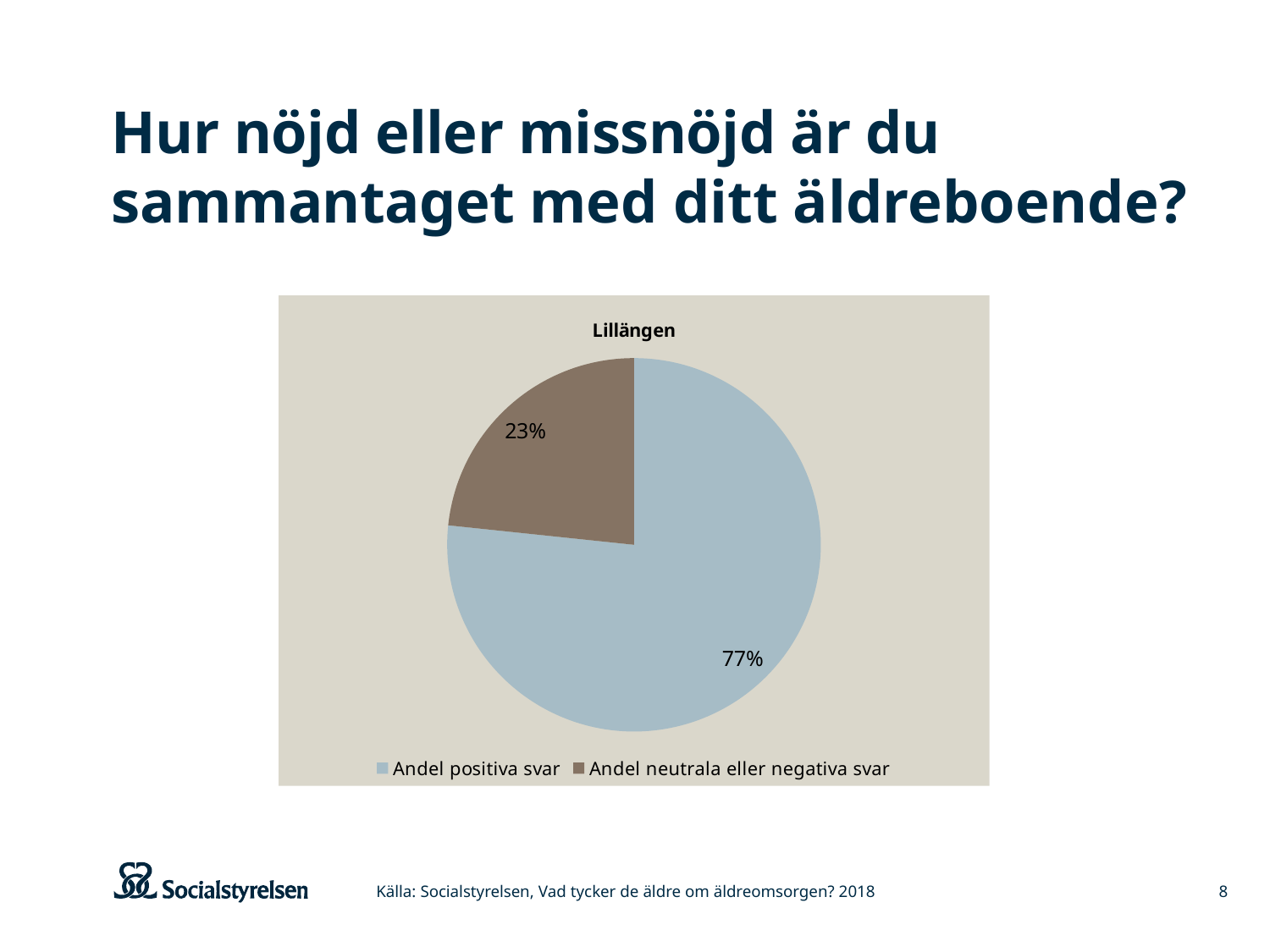
What kind of chart is shown on the slide? Pie chart What share of the pie is 'Andel neutrala eller negativa svar'? 23% How many slices does the pie chart have? 2 How many entries does the legend list? 2 Which slice is the smallest in the pie chart? Andel neutrala eller negativa svar Which is larger, 'Andel positiva svar' or 'Andel neutrala eller negativa svar'? Andel positiva svar What share of the pie is 'Andel positiva svar'? 77% Which slice is the largest in the pie chart? Andel positiva svar Which legend entry is shown in brown? Andel neutrala eller negativa svar What is the difference in percentage points between 'Andel positiva svar' and 'Andel neutrala eller negativa svar'? 54 What is the title of the chart? Lillängen